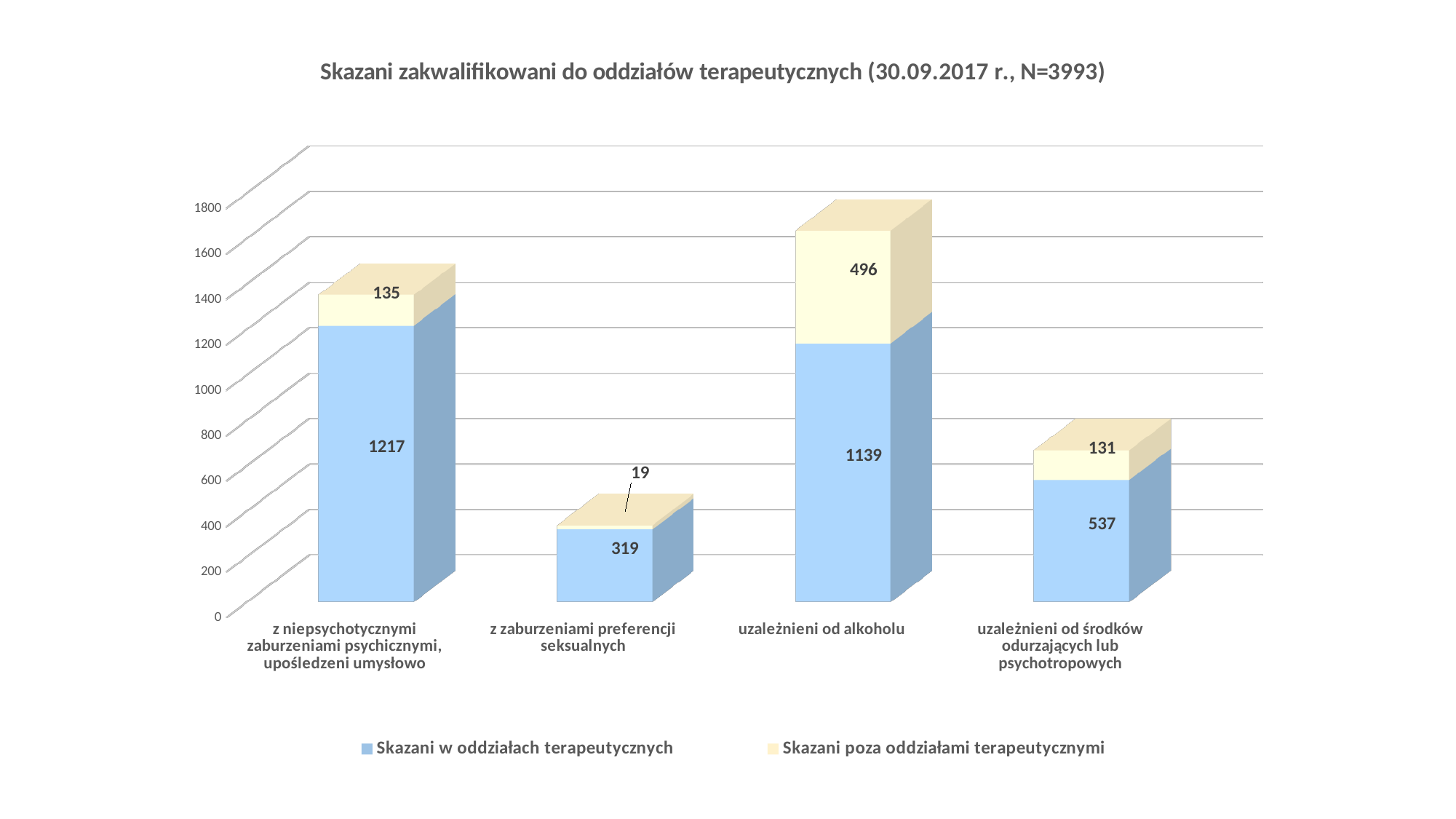
How many categories are shown on the x axis? 4 What is the total of the stacked bar for "uzależnieni od alkoholu"? 1635 Which is larger: the "Skazani poza oddziałami terapeutycznymi" value for "uzależnieni od alkoholu" or for "z niepsychotycznymi zaburzeniami psychicznymi, upośledzeni umysłowo"? uzależnieni od alkoholu What kind of chart is shown on the slide? stacked bar chart Which category has the lowest value for "Skazani poza oddziałami terapeutycznymi"? z zaburzeniami preferencji seksualnych Which category has the highest value for "Skazani w oddziałach terapeutycznych"? z niepsychotycznymi zaburzeniami psychicznymi, upośledzeni umysłowo What is the difference between the "Skazani w oddziałach terapeutycznych" values for "z niepsychotycznymi zaburzeniami psychicznymi, upośledzeni umysłowo" and "uzależnieni od alkoholu"? 78 What is the value of "Skazani poza oddziałami terapeutycznymi" for "z zaburzeniami preferencji seksualnych"? 19 What is the value of "Skazani w oddziałach terapeutycznych" for "uzależnieni od alkoholu"? 1139 What is the value of "Skazani poza oddziałami terapeutycznymi" for "uzależnieni od środków odurzających lub psychotropowych"? 131 How many series does the legend list? 2 What is the total of the stacked bar for "uzależnieni od środków odurzających lub psychotropowych"? 668